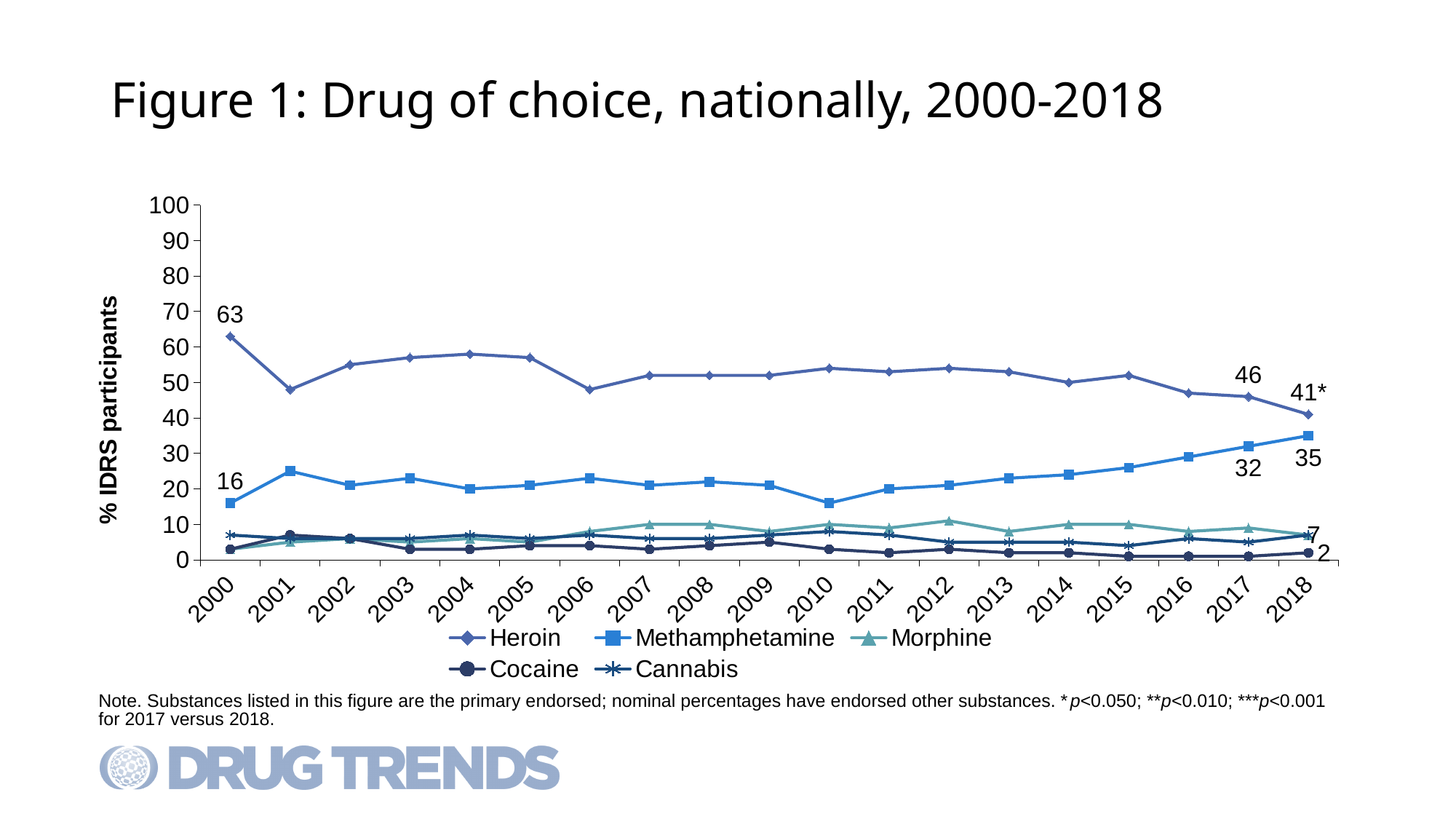
Which series has the higher value in 2018, Heroin or Methamphetamine? Heroin What is the value for Heroin in 2017? 46 How many series does the legend list? 5 How many years are shown on the x axis? 19 Is the value for Heroin in 2004 greater or less than 50? greater What is the value for Methamphetamine in 2018? 35 By how much did the Methamphetamine value increase from 2017 to 2018? 3 What kind of chart is shown on the slide? line chart What is the difference between the Heroin value in 2000 and in 2017? 17 Does the Methamphetamine series rise or fall from 2010 to 2018? rise What is the value for Cocaine in 2018? 2 What is the value for Heroin in 2000? 63